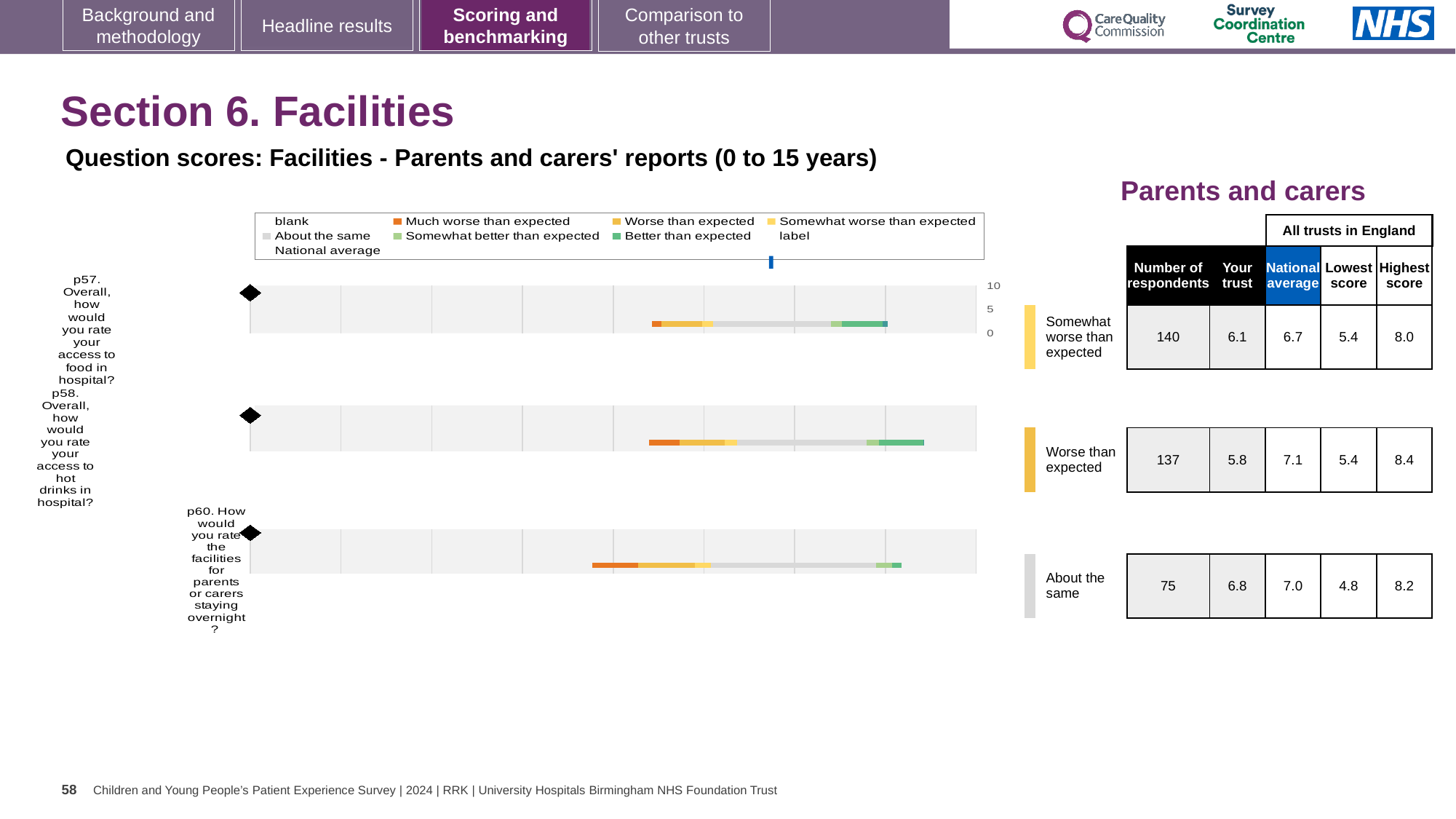
Which benchmark category is shown for p57 (access to food in hospital)? Somewhat worse than expected How many survey questions are plotted in the chart? 3 Which question has the highest 'Your trust' score? p60 For p57, which is larger: the 'Your trust' score or the national average? National average What is the national average score for p60 (facilities for parents or carers staying overnight)? 7.0 How many respondents answered p58 (access to hot drinks in hospital)? 137 What is the highest score among all trusts in England for p58? 8.4 For p58, how much higher is the national average than the 'Your trust' score? 1.3 Which question has the lowest 'Your trust' score? p58 What kind of chart is used to show the question scores? bar chart What is the 'Your trust' score for p57 (access to food in hospital)? 6.1 What is the lowest score among all trusts in England for p60? 4.8